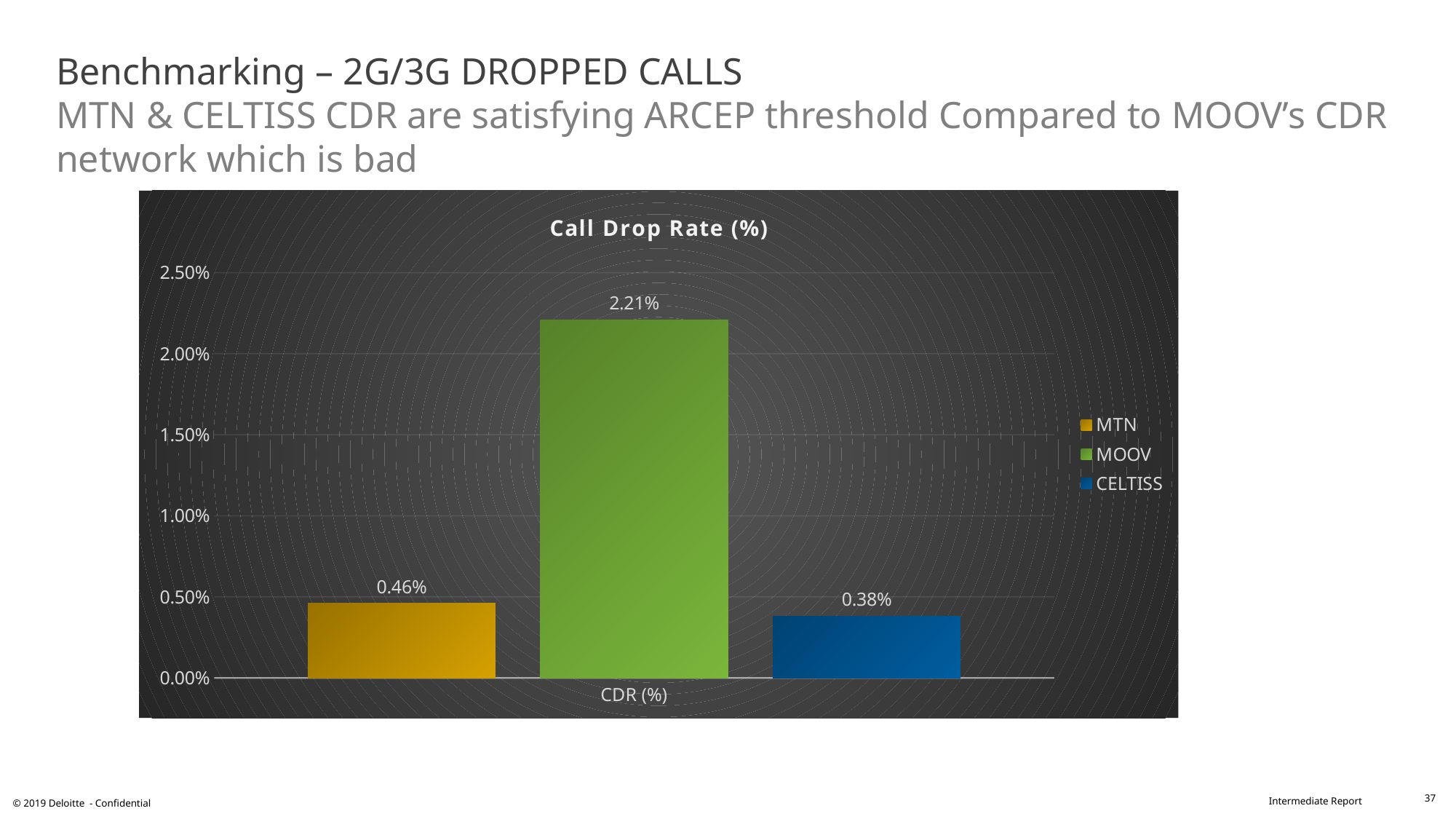
What is the difference between MTN's and CELTISS's call drop rates? 0.08% What is the call drop rate for MTN? 0.46% What is the call drop rate for CELTISS? 0.38% What is the title of the chart? Call Drop Rate (%) Which is larger, the call drop rate for MTN or for CELTISS? MTN What kind of chart is shown on the slide? Bar chart Which operator has the lowest call drop rate? CELTISS Is the call drop rate for MOOV greater or less than 2.00%? greater How many series does the legend list? 3 What is the difference between MOOV's and MTN's call drop rates? 1.75% What is the call drop rate for MOOV? 2.21% Which operator has the highest call drop rate? MOOV